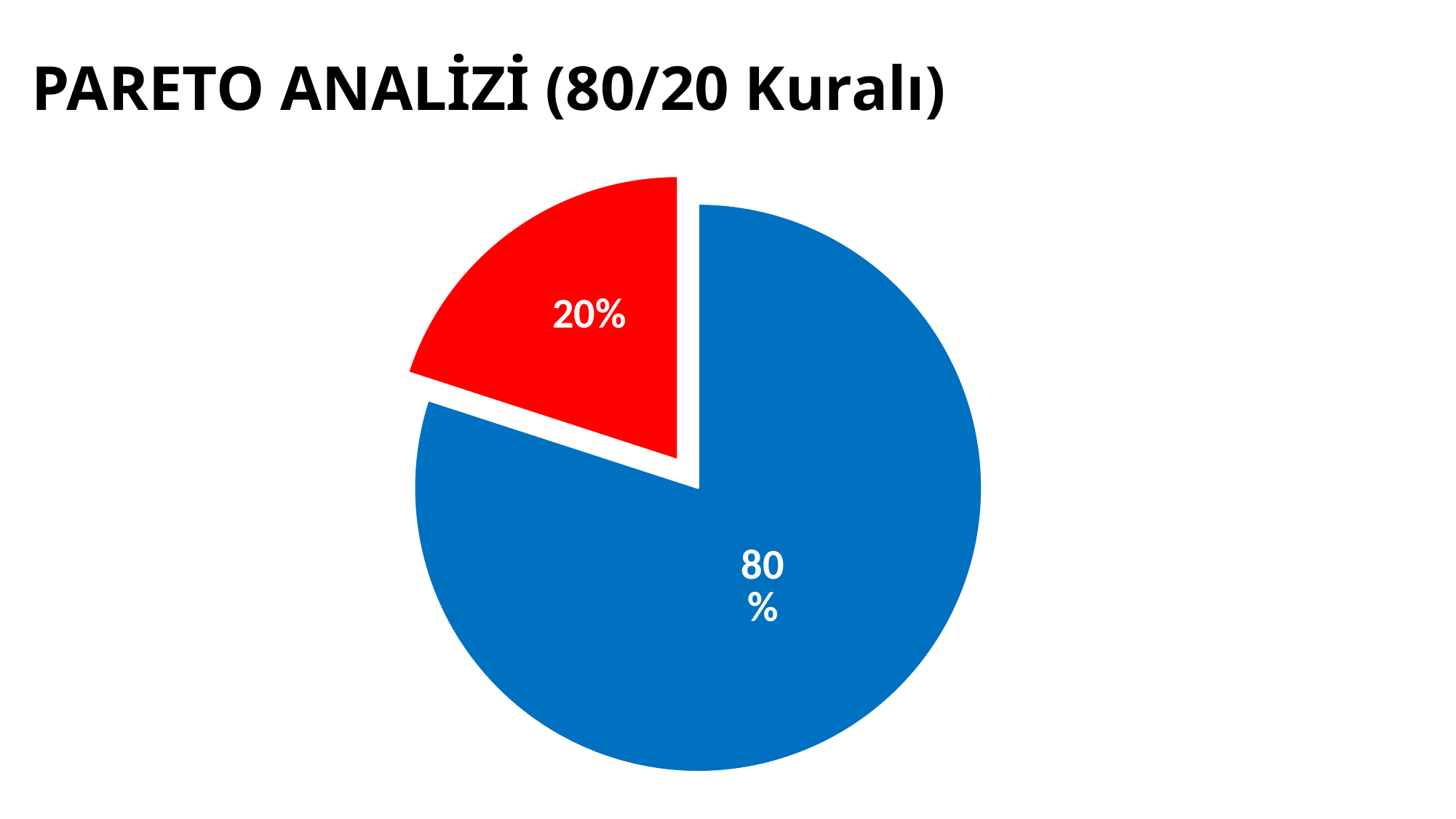
Which slice of the pie chart is the largest? the blue slice (80%) What kind of chart is shown on the slide? pie chart What percentage is shown on the blue slice of the pie chart? 80% Which is larger in the pie chart, the red slice or the blue slice? the blue slice What is the total of the two slices shown in the pie chart? 100% What is the difference between the blue slice and the red slice in the pie chart? 60% Which slice of the pie chart is the smallest? the red slice (20%) What percentage is shown on the red slice of the pie chart? 20% Which slice of the pie chart is pulled out (exploded) from the rest? the red 20% slice How many slices does the pie chart have? 2 What is the title of the slide containing the pie chart? PARETO ANALİZİ (80/20 Kuralı)